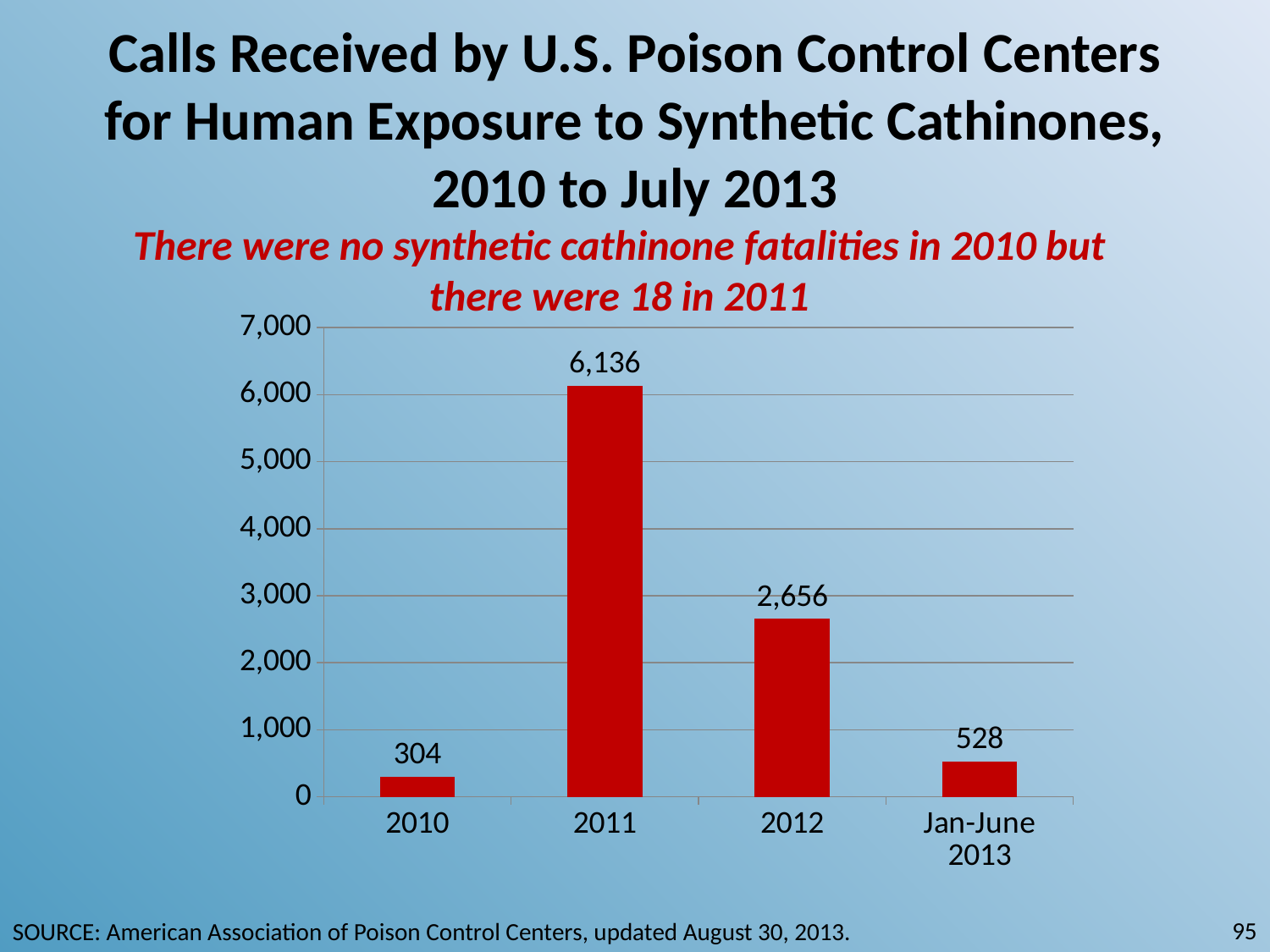
How many calls were received in 2011? 6,136 What kind of chart is shown on the slide? bar chart What is the value for Jan-June 2013? 528 What colour are the bars in the chart? red Do the values rise or fall from 2011 to 2012? fall How many calls were received in 2010? 304 Is the value for 2012 greater or less than 3,000? less Which is larger, the value for 2012 or the value for Jan-June 2013? 2012 What is the difference between the 2011 and 2012 values? 3,480 How many categories are shown on the x axis? 4 Which year had the highest number of calls? 2011 Which category had the lowest number of calls? 2010